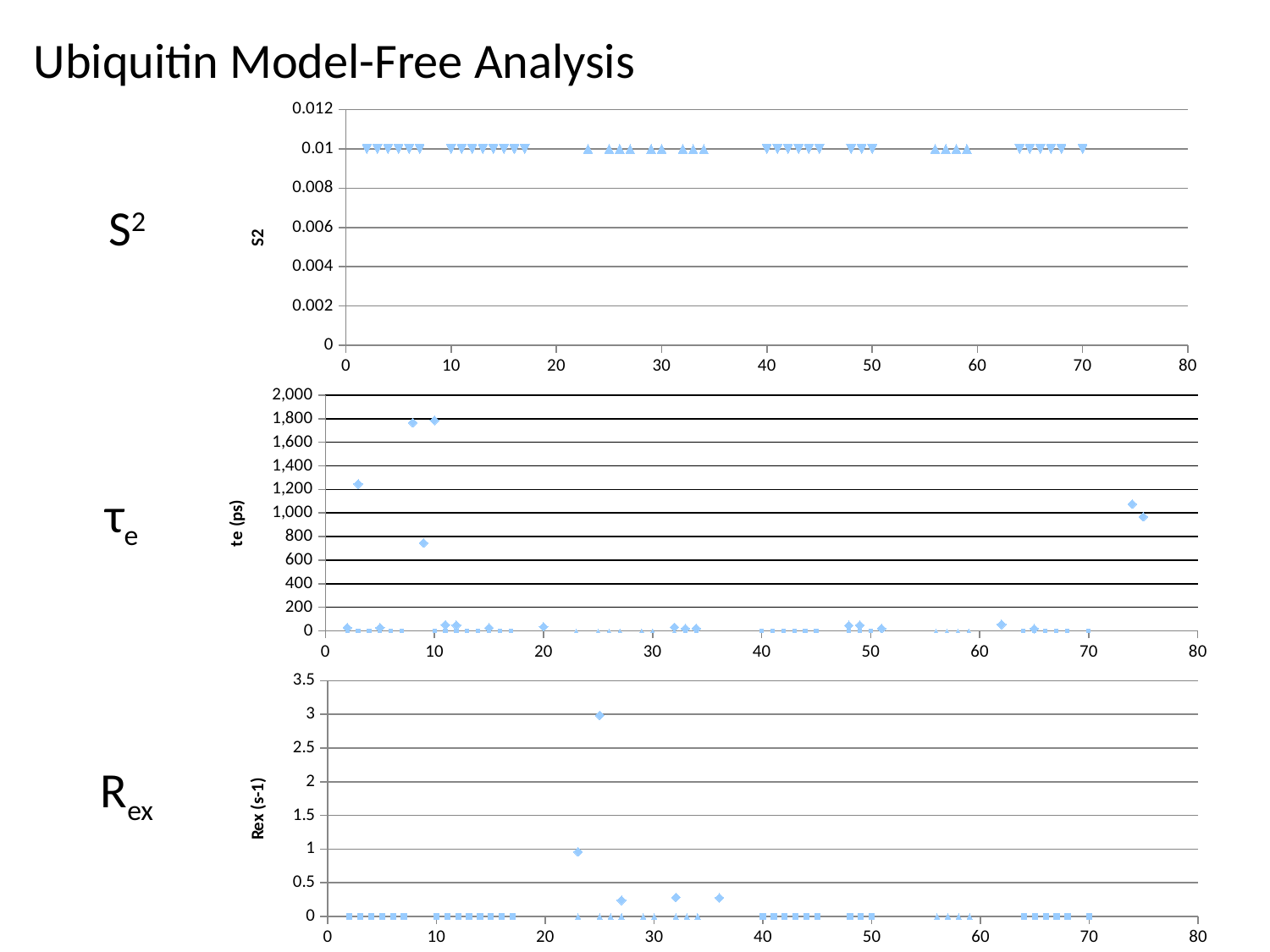
What is the y-axis label of the middle chart? te (ps) What is the y-axis label of the bottom chart? Rex (s-1) What kind of chart is the top chart (S2)? scatter chart In the middle chart (te), is the point near x=3 greater or less than 1,000? greater In the bottom chart (Rex), is the point near x=23 greater or less than 0.5? greater What is the maximum value shown on the x axis of the bottom chart? 80 In the bottom chart (Rex), is the highest point greater or less than 2.5? greater In the middle chart (te), which is larger: the point near x=3 or the point near x=9? the point near x=3 How many charts are shown on the slide? 3